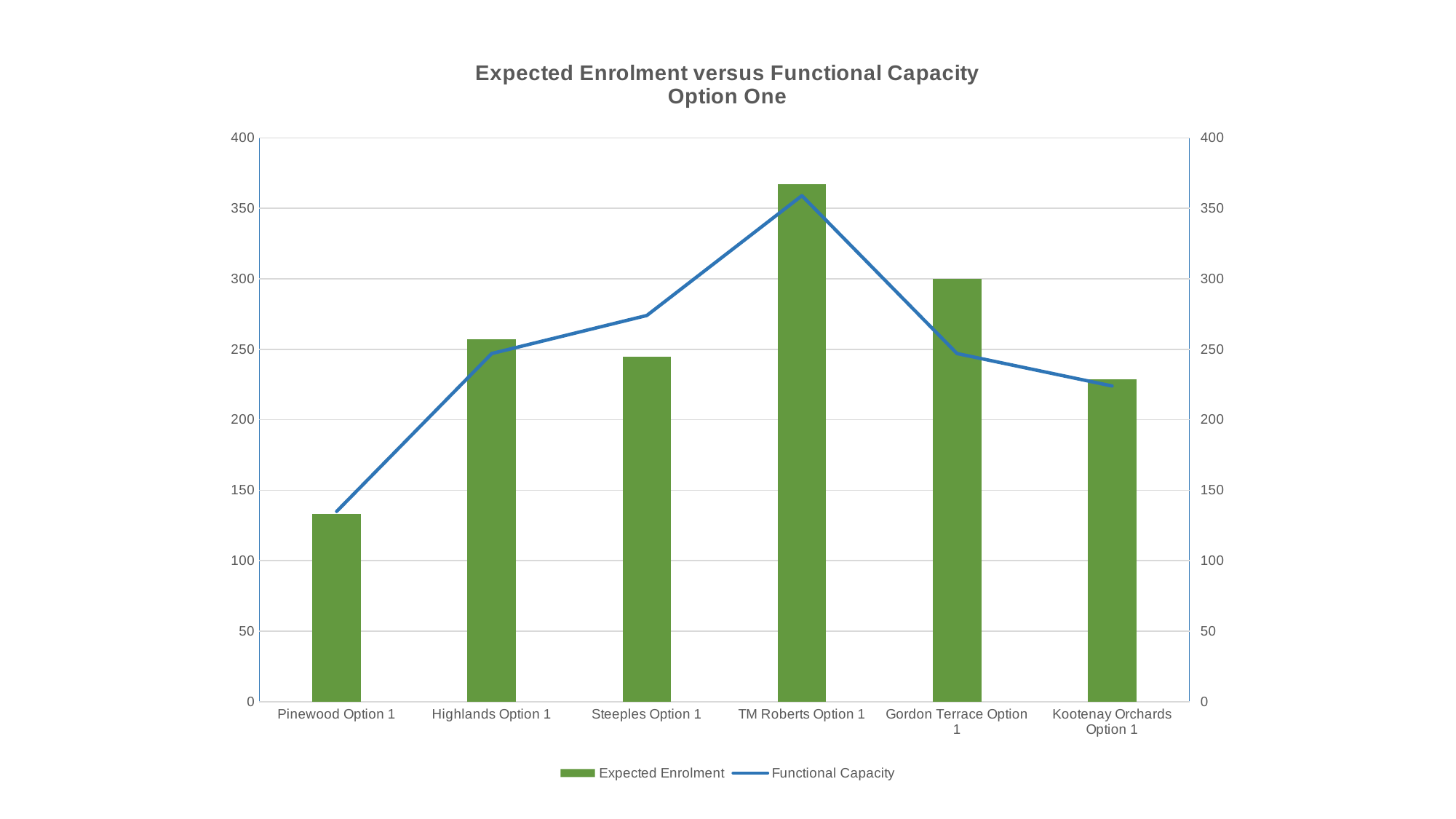
Which category has the highest Expected Enrolment? TM Roberts Option 1 Which category has the highest Functional Capacity? TM Roberts Option 1 How many categories are shown on the x axis? 6 What is the title of the chart? Expected Enrolment versus Functional Capacity Option One Is the Functional Capacity for Steeples Option 1 greater or less than 250? greater How many series does the legend list? 2 Is the Expected Enrolment for Pinewood Option 1 greater or less than 150? less Which has the larger Expected Enrolment, Gordon Terrace Option 1 or Kootenay Orchards Option 1? Gordon Terrace Option 1 Which category has the lowest Expected Enrolment? Pinewood Option 1 Is the Expected Enrolment for TM Roberts Option 1 greater or less than 350? greater What type of chart is shown on the slide? A combined bar and line chart Which series is drawn as a line in the chart? Functional Capacity